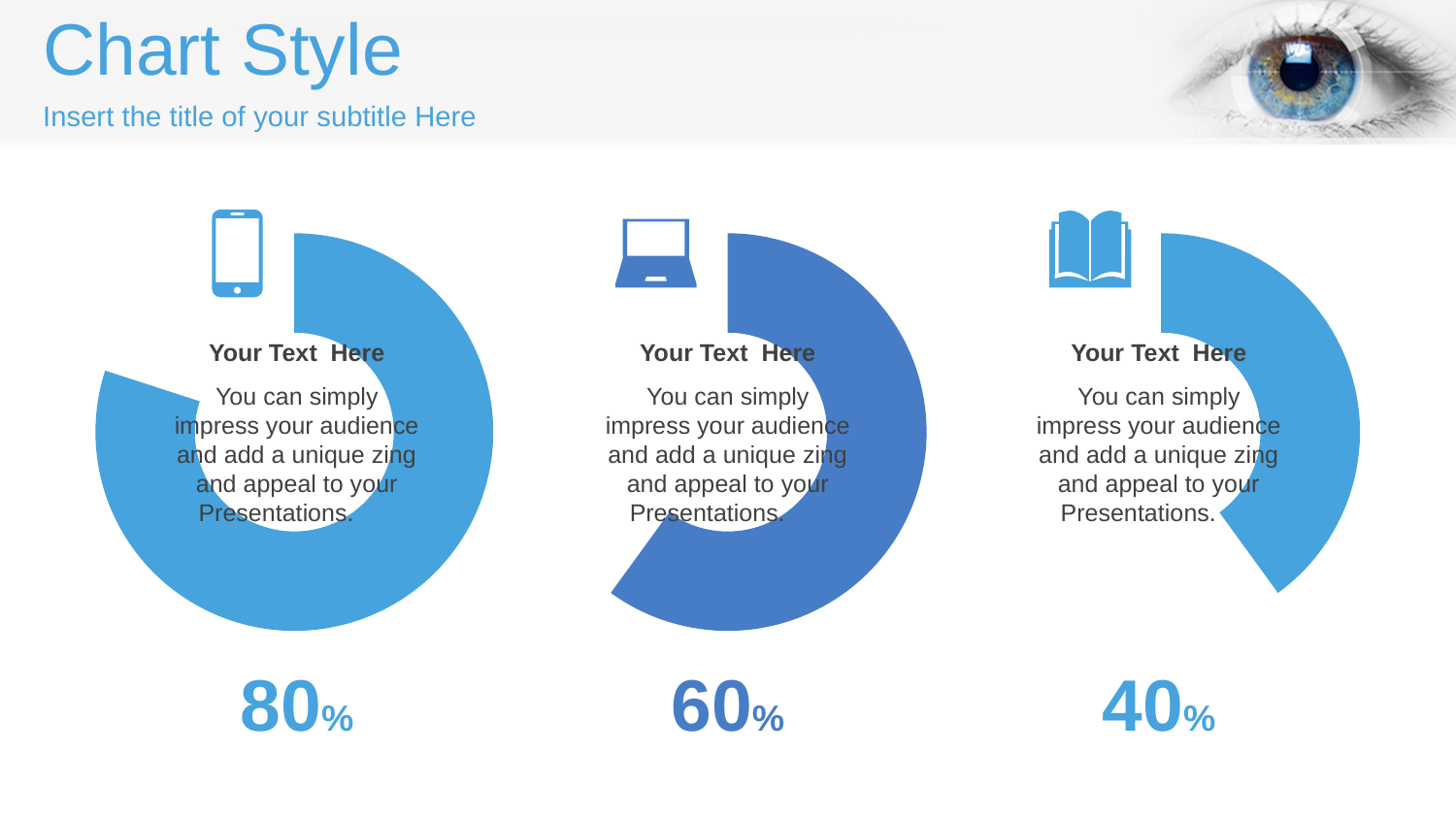
Which of the three doughnut charts shows the lowest percentage? The right chart (40%) How many doughnut charts are shown on the slide? 3 What kind of chart is used on this slide? Doughnut chart What is the difference between the percentage of the left chart and the percentage of the right chart? 40% What percentage is shown below the right doughnut chart (with the book icon)? 40% Which is larger, the percentage of the middle chart or the percentage of the right chart? The middle chart (60%) What is the difference between the percentage of the left chart and the percentage of the middle chart? 20% What percentage is shown below the middle doughnut chart (with the laptop icon)? 60% Do the percentages rise or fall from the left chart to the right chart? Fall What percentage is shown below the left doughnut chart (with the phone icon)? 80% What is the title of the slide? Chart Style Which of the three doughnut charts shows the highest percentage? The left chart (80%)